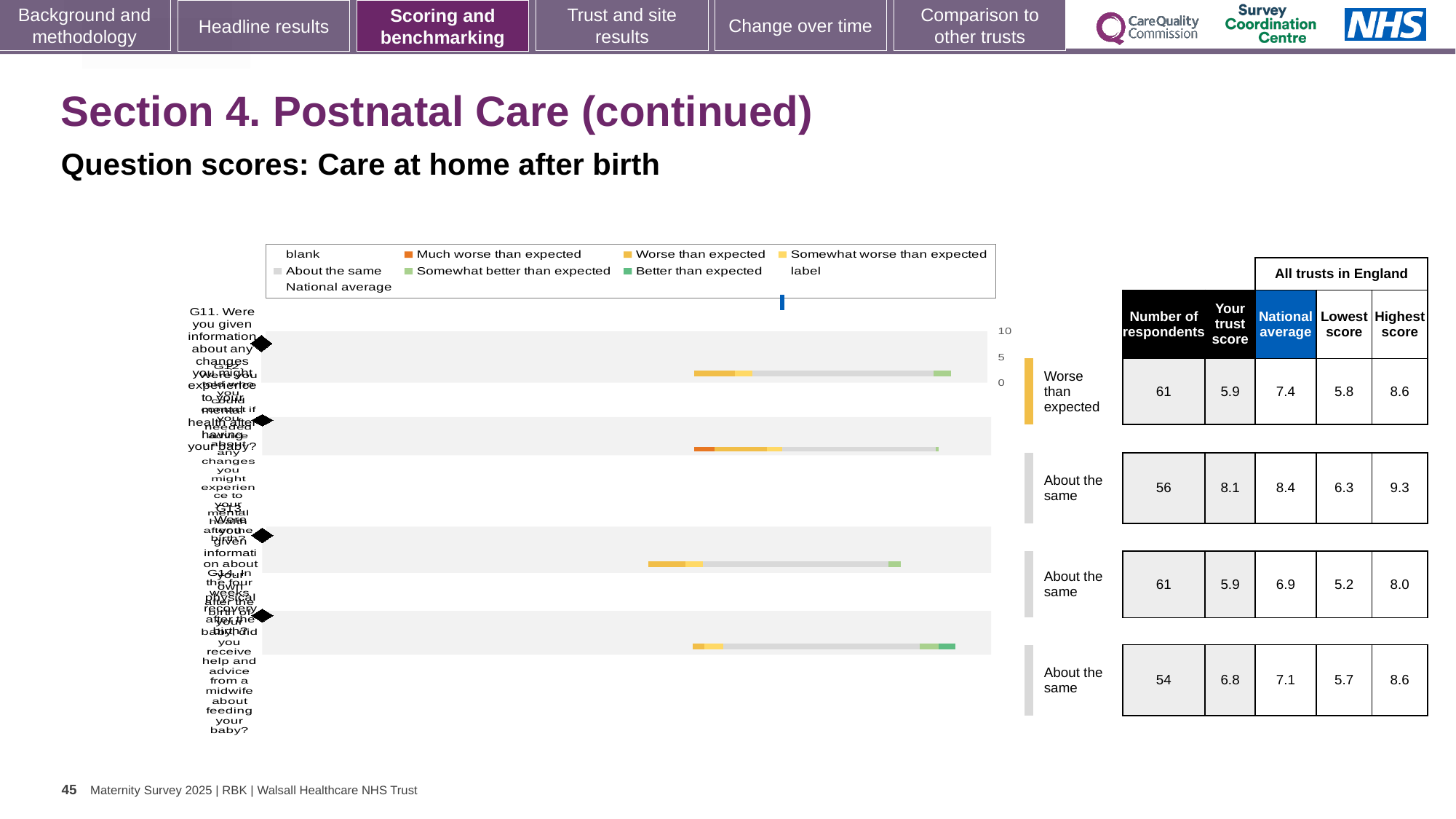
What is the "Your trust score" for the first (top) row? 5.9 What is the number of respondents for the fourth (bottom) row? 54 How many of the four rows are labelled "About the same"? 3 In the third row, which is larger: the trust score or the national average? the national average What is the national average for the second row? 8.4 What benchmark category is shown for the first (top) row of the chart? Worse than expected What is the highest score for the second row? 9.3 For the first (top) row, what is the difference between the national average and the trust score? 1.5 How many question rows are plotted in the chart? 4 What kind of chart is shown on the slide? bar chart What is the lowest score for the third row? 5.2 Which row has the highest "Your trust score"? the second row (8.1)